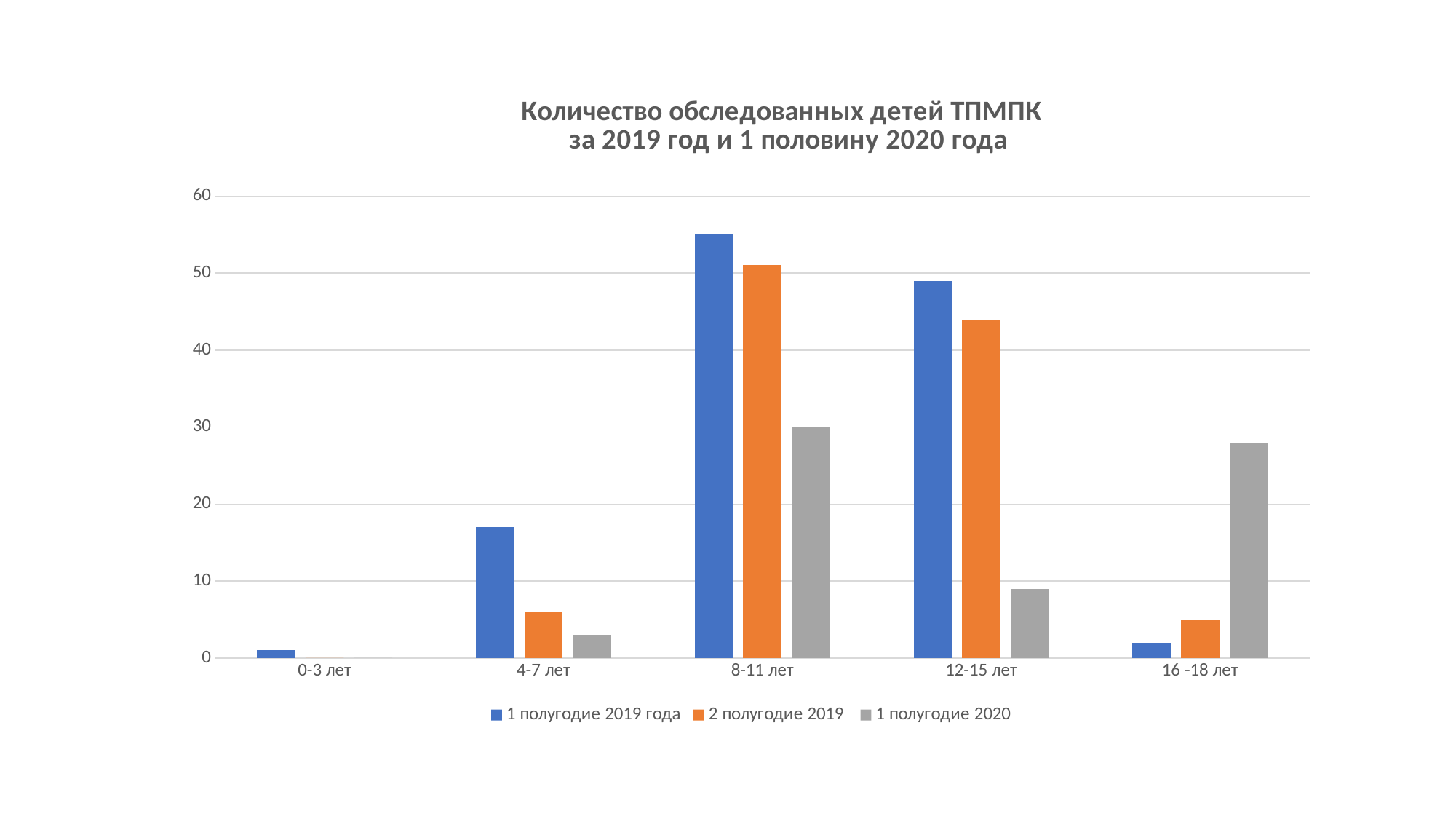
What kind of chart is shown on the slide? bar chart Is the value for 1 полугодие 2019 года in the 8-11 лет category greater or less than 50? greater Which age category has the highest value for 1 полугодие 2020? 8-11 лет What is the title of the chart? Количество обследованных детей ТПМПК за 2019 год и 1 половину 2020 года Is the value for 1 полугодие 2019 года in the 4-7 лет category greater or less than 20? less Which age category has the highest value for 1 полугодие 2019 года? 8-11 лет How many series does the legend list? 3 In the 16 -18 лет category, which series has the larger value: 1 полугодие 2020 or 2 полугодие 2019? 1 полугодие 2020 Which age category has the lowest value for 1 полугодие 2019 года? 0-3 лет Is the value for 2 полугодие 2019 in the 12-15 лет category greater or less than 40? greater How many age categories are shown on the x axis? 5